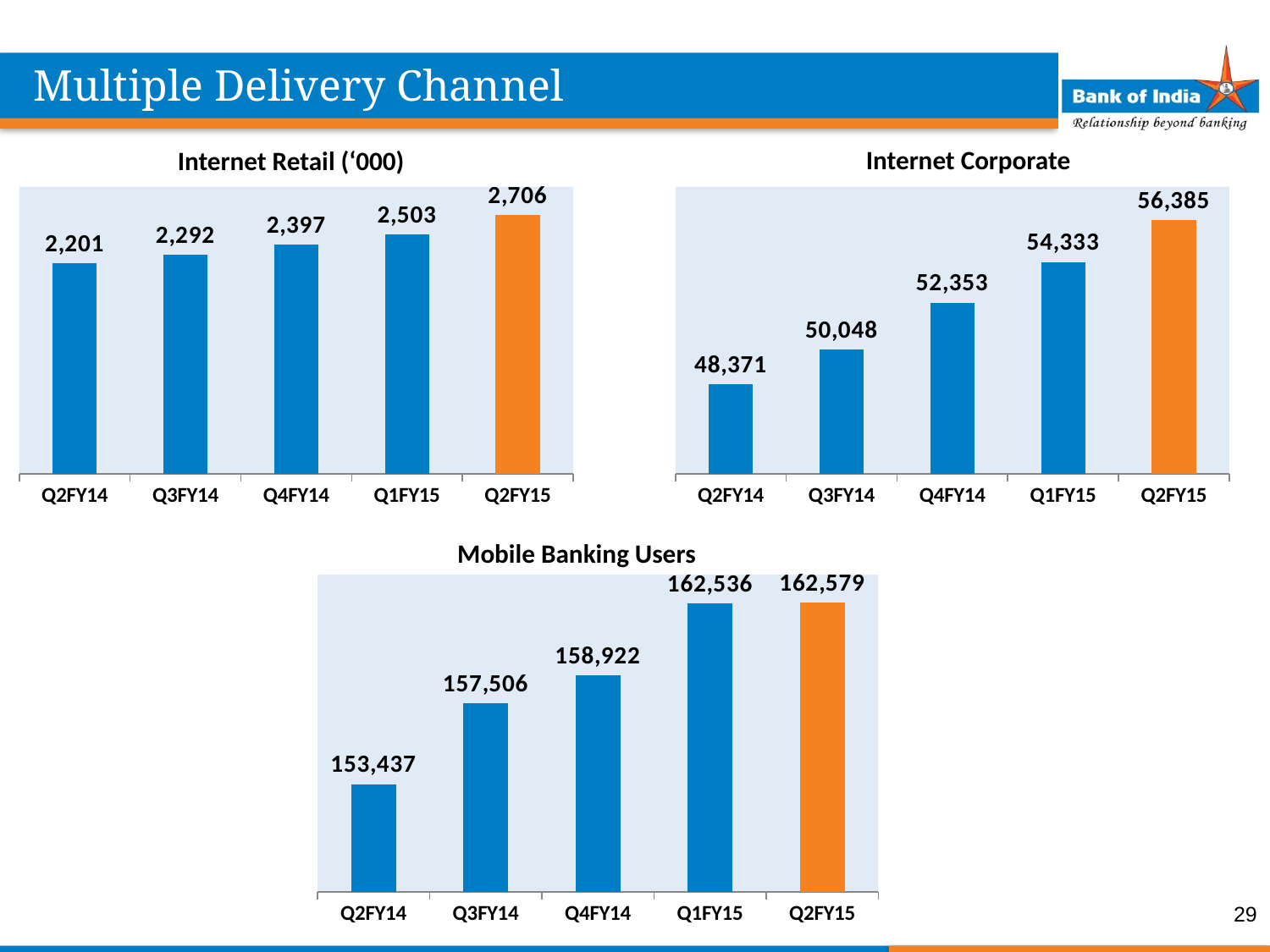
In the Internet Corporate chart, which quarter has the lowest value? Q2FY14 In the Mobile Banking Users chart, which is larger, Q4FY14 or Q3FY14? Q4FY14 In the Internet Retail ('000) chart, do the values rise or fall from Q2FY14 to Q2FY15? Rise In the Internet Retail ('000) chart, which quarter has the highest value? Q2FY15 In the Internet Corporate chart, what is the value for Q4FY14? 52,353 What kind of chart is the Mobile Banking Users chart? Bar chart In the Internet Corporate chart, what is the difference between Q1FY15 and Q4FY14? 1,980 How many quarters are shown in the Internet Corporate chart? 5 In the Mobile Banking Users chart, what is the difference between Q2FY15 and Q1FY15? 43 In the Internet Retail ('000) chart, what is the difference between Q2FY15 and Q2FY14? 505 In the Internet Retail ('000) chart, what is the value for Q2FY15? 2,706 In the Mobile Banking Users chart, what is the value for Q3FY14? 157,506